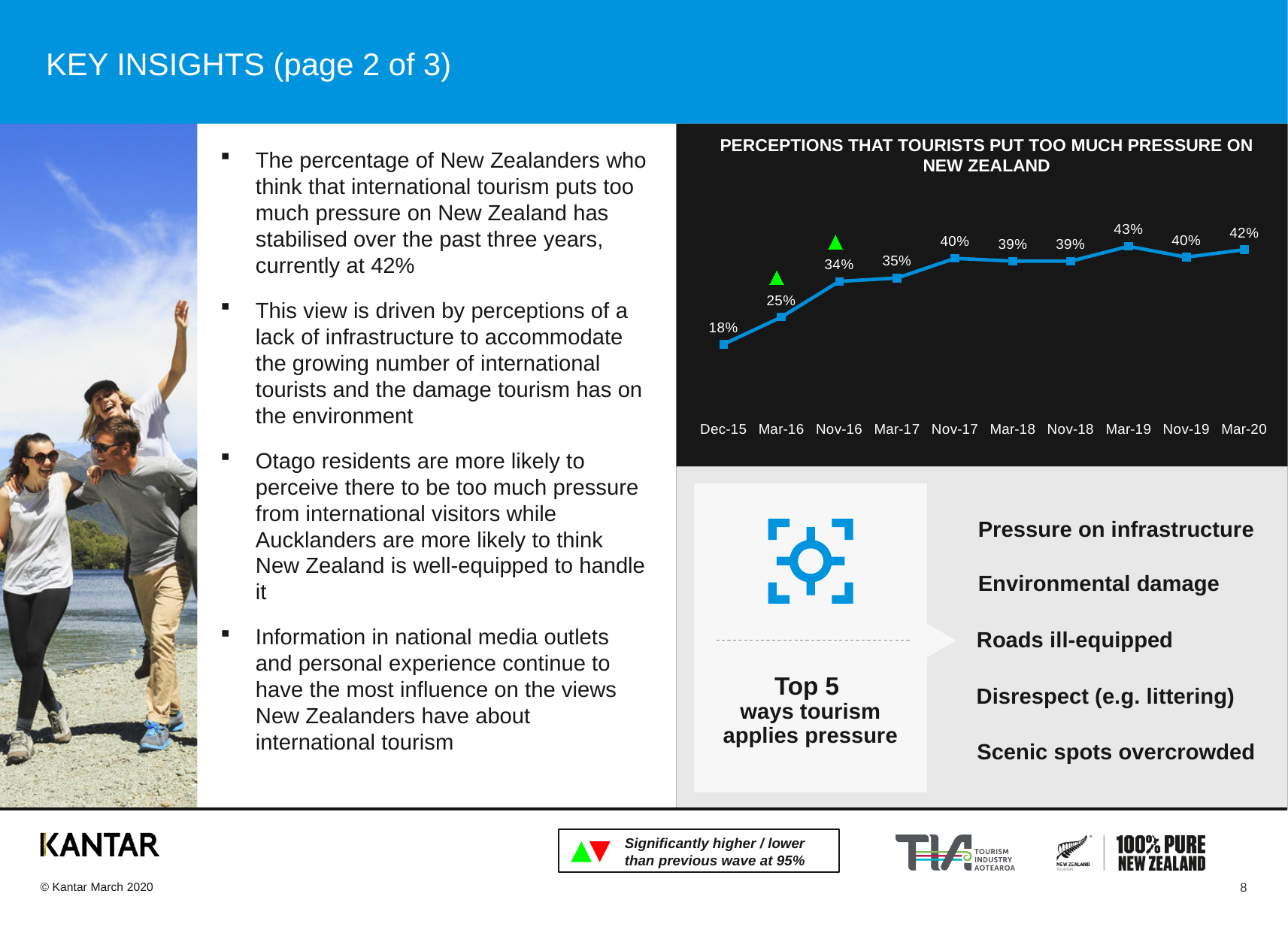
What is the difference between the Mar-19 value and the Nov-19 value? 3% Which time point has the highest value in the chart? Mar-19 What is the difference between the Mar-20 value and the Dec-15 value? 24% How many time points are plotted in the chart? 10 Do the values in the chart generally rise or fall from Dec-15 to Mar-20? Rise Which is larger, the value for Mar-16 or the value for Mar-17? Mar-17 What is the title of the chart on the slide? Perceptions that tourists put too much pressure on New Zealand What is the value for Dec-15 in the chart? 18% Which time point has the lowest value in the chart? Dec-15 What kind of chart is shown on the slide? Line chart What is the value for Mar-20 in the chart 'Perceptions that tourists put too much pressure on New Zealand'? 42% What is the value for Nov-16 in the chart? 34%